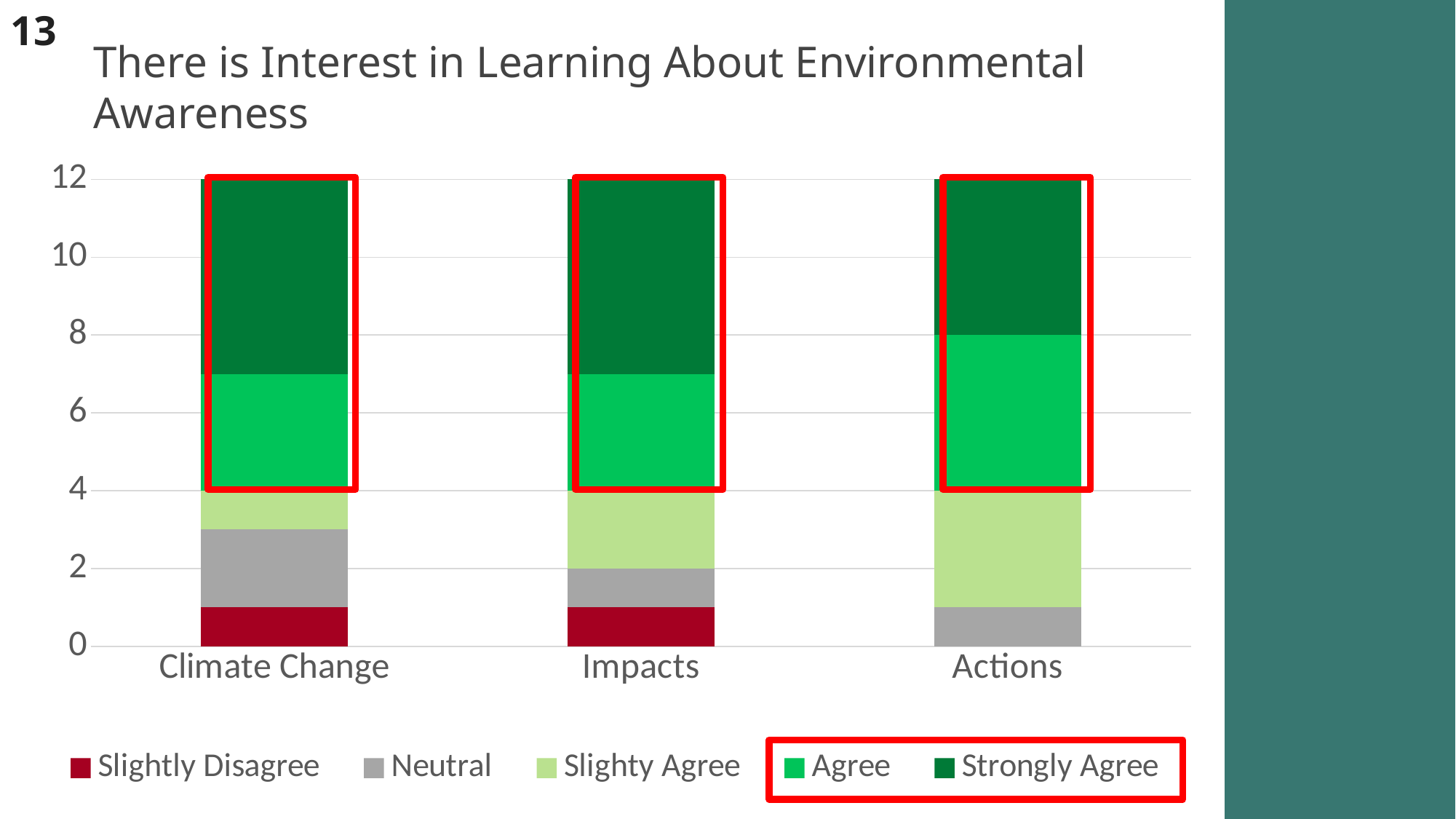
Is the Neutral segment for Impacts greater or less than 2? less What is the total height of the stacked bar for Climate Change? 12 What is the value of the Agree segment for Actions? 4 Which legend entries are highlighted with a red box? Agree and Strongly Agree What kind of chart is shown on the slide? Stacked bar chart How many series does the legend list? 5 What is the value of the Slighty Agree segment for Impacts? 2 What is the total height of the stacked bar for Actions? 12 How many categories are shown on the x axis? 3 Which category has the largest Neutral segment? Climate Change Is the Strongly Agree segment for Climate Change greater or less than 4? greater Which category has the smallest Strongly Agree segment? Actions